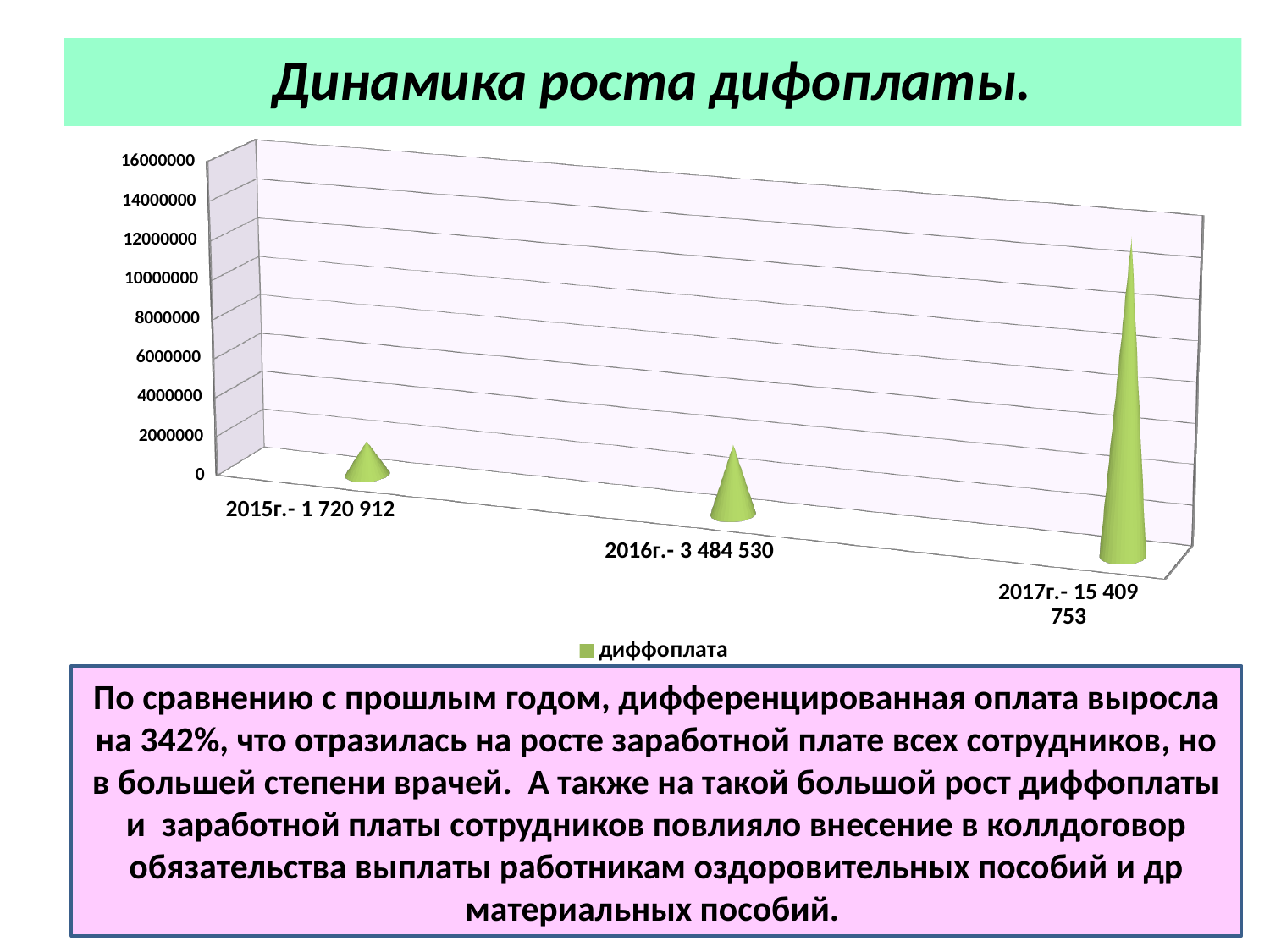
Do the диффоплата values rise or fall from 2015г. to 2017г.? rise What is the value of диффоплата for 2017г.? 15 409 753 What is the title of the chart? Динамика роста дифоплаты. Which year has the lowest диффоплата value? 2015г. Is the value for 2017г. greater or less than 14000000? greater What is the difference between the диффоплата values for 2017г. and 2016г.? 11 925 223 What is the value of диффоплата for 2015г.? 1 720 912 Which year has the highest диффоплата value? 2017г. What is the value of диффоплата for 2016г.? 3 484 530 How many years are shown on the chart? 3 Which is larger, the диффоплата value for 2016г. or for 2015г.? 2016г. What is the difference between the диффоплата values for 2016г. and 2015г.? 1 763 618